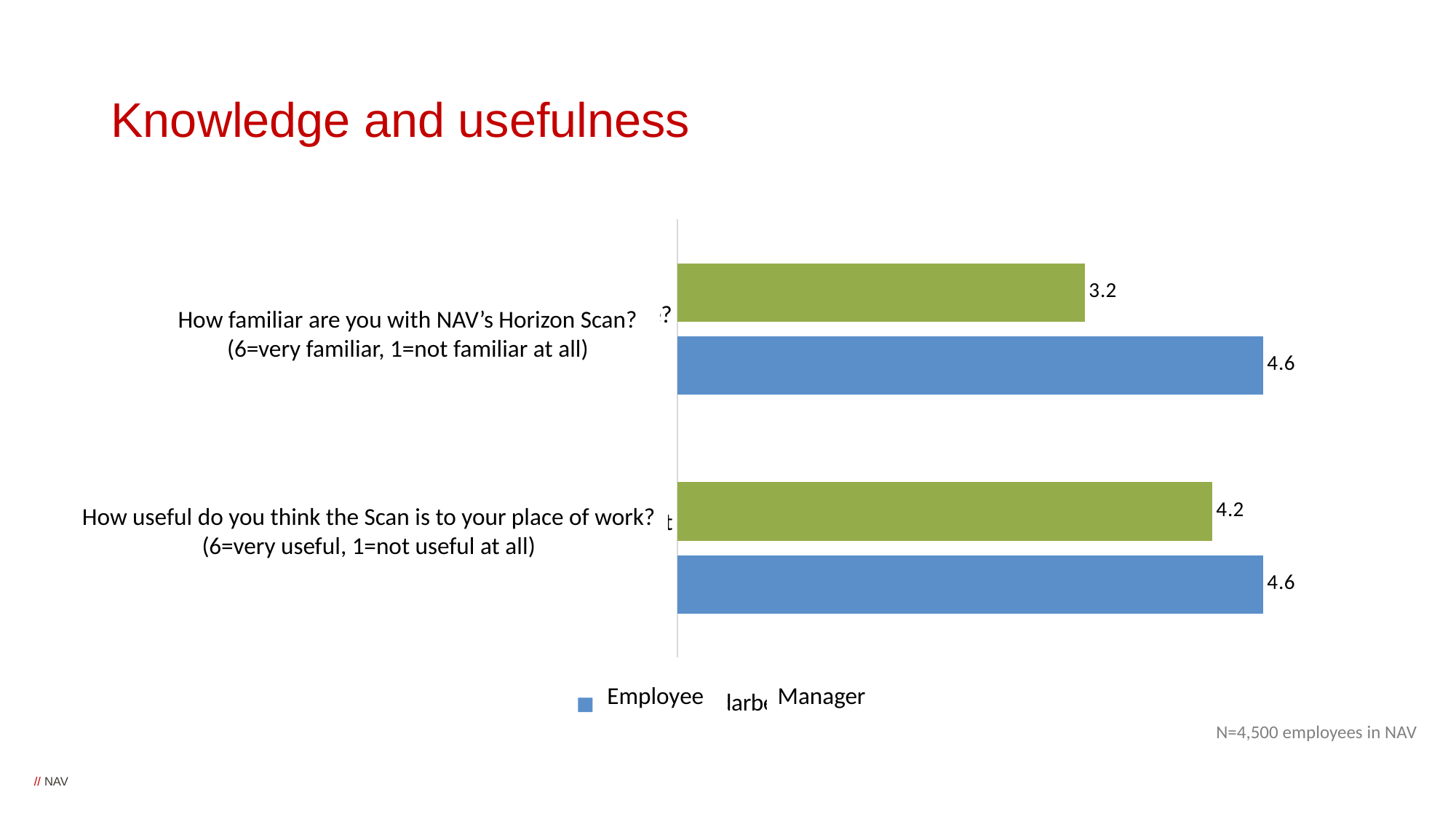
Which series has the lowest value shown on the chart, and for which question? Employee, for "How familiar are you with NAV's Horizon Scan?" (3.2) For "How familiar are you with NAV's Horizon Scan?", which group has the higher value, Employee or Manager? Manager What is the difference between the Employee and Manager values for "How familiar are you with NAV's Horizon Scan?"? 1.4 What is the Employee value for "How familiar are you with NAV's Horizon Scan?"? 3.2 What is the Manager value for "How familiar are you with NAV's Horizon Scan?"? 4.6 How many series does the legend list? 2 What is the Manager value for "How useful do you think the Scan is to your place of work?"? 4.6 What kind of chart is shown on the slide? Bar chart What is the Employee value for "How useful do you think the Scan is to your place of work?"? 4.2 How many questions (categories) are shown on the chart? 2 What is the difference between the Employee and Manager values for "How useful do you think the Scan is to your place of work?"? 0.4